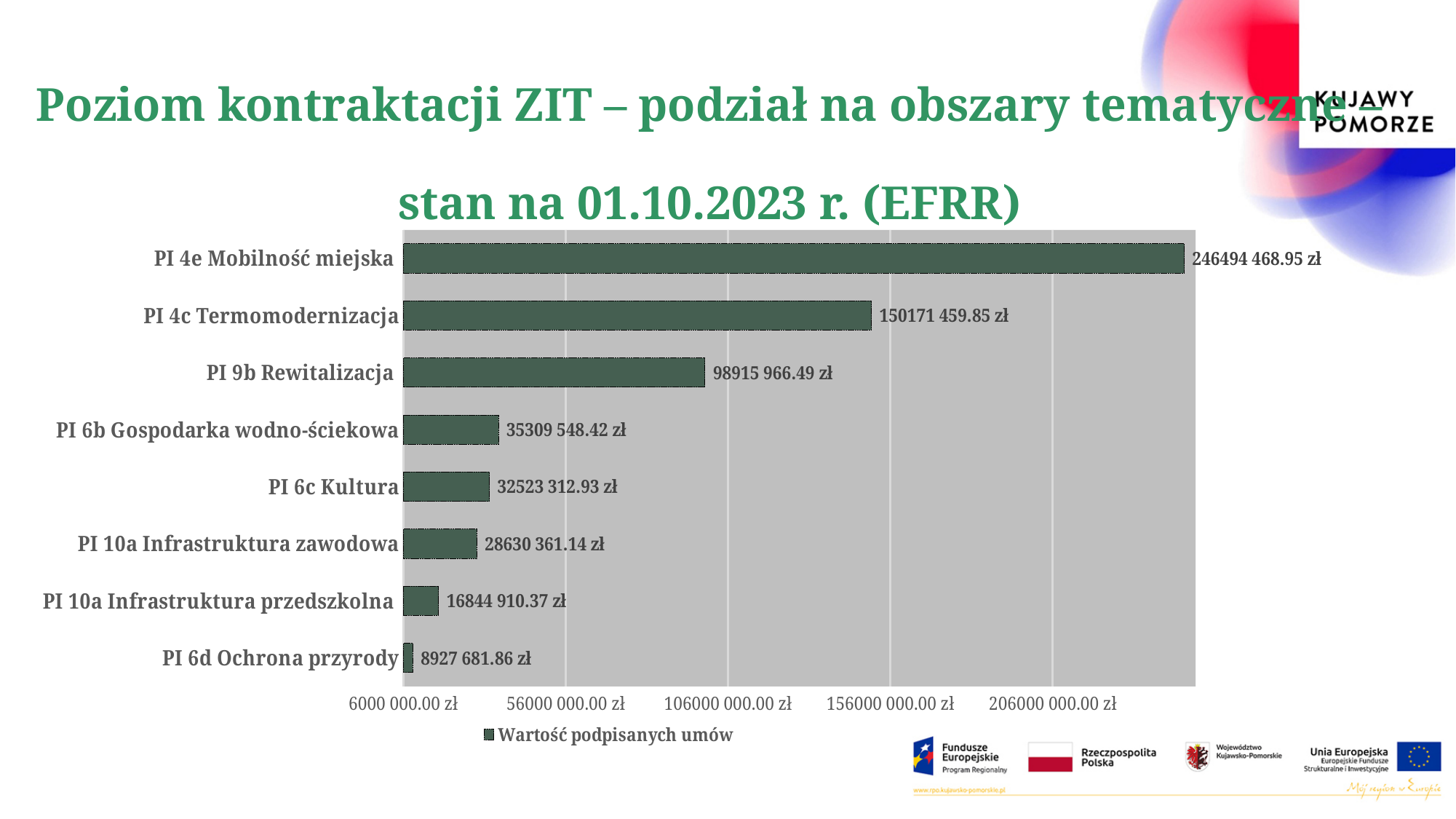
What is the difference between the values for PI 4e Mobilność miejska and PI 4c Termomodernizacja? 96323 009.10 zł Which is larger, the value for PI 6b Gospodarka wodno-ściekowa or PI 10a Infrastruktura zawodowa? PI 6b Gospodarka wodno-ściekowa Which category has the highest value? PI 4e Mobilność miejska What is the value for PI 10a Infrastruktura przedszkolna? 16844 910.37 zł Which category has the lowest value? PI 6d Ochrona przyrody What is the value for PI 4e Mobilność miejska? 246494 468.95 zł How many series does the legend list? 1 What is the value for PI 9b Rewitalizacja? 98915 966.49 zł What is the name of the series shown in the legend? Wartość podpisanych umów What kind of chart is shown on the slide? bar chart How many categories are shown in the chart? 8 Is the value for PI 4c Termomodernizacja greater or less than 106000 000.00 zł? greater